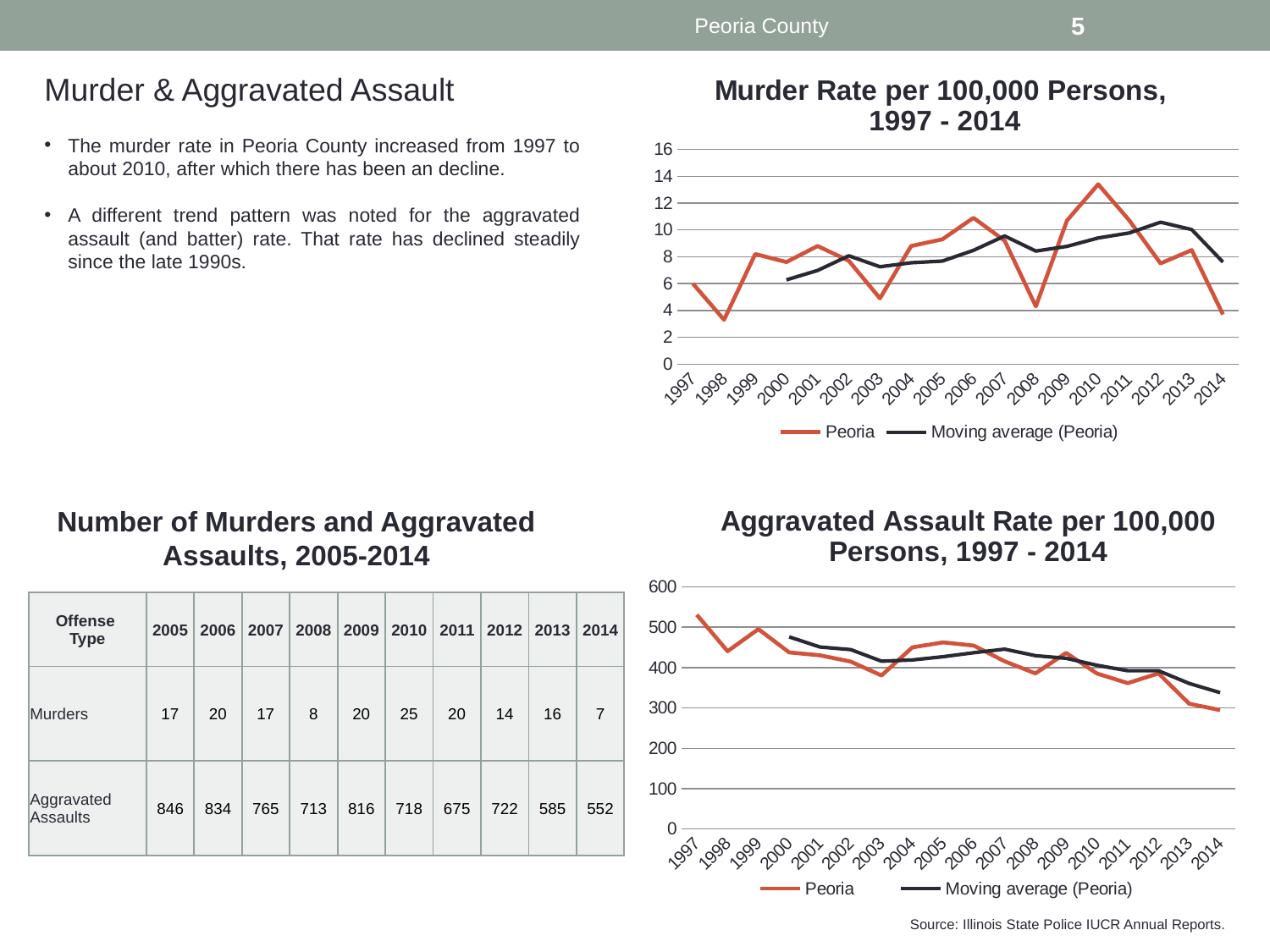
In the "Murder Rate per 100,000 Persons, 1997 - 2014" chart, is the Peoria value for 2008 greater or less than 6? less In the "Aggravated Assault Rate per 100,000 Persons, 1997 - 2014" chart, is the Peoria value for 1997 greater or less than 500? greater In the "Murder Rate per 100,000 Persons, 1997 - 2014" chart, which year has the highest Peoria murder rate? 2010 In the "Murder Rate per 100,000 Persons, 1997 - 2014" chart, is the Peoria value for 2006 greater or less than 10? greater How many series does the legend of the "Murder Rate per 100,000 Persons, 1997 - 2014" chart list? 2 In the "Aggravated Assault Rate per 100,000 Persons, 1997 - 2014" chart, which year has the highest Peoria aggravated assault rate? 1997 In the "Aggravated Assault Rate per 100,000 Persons, 1997 - 2014" chart, does the Peoria aggravated assault rate generally rise or fall from 1997 to 2014? Fall How many years are shown on the x axis of the "Murder Rate per 100,000 Persons, 1997 - 2014" chart? 18 What are the two legend entries in the "Aggravated Assault Rate per 100,000 Persons, 1997 - 2014" chart? Peoria and Moving average (Peoria) What type of chart is the "Murder Rate per 100,000 Persons, 1997 - 2014" chart? Line chart